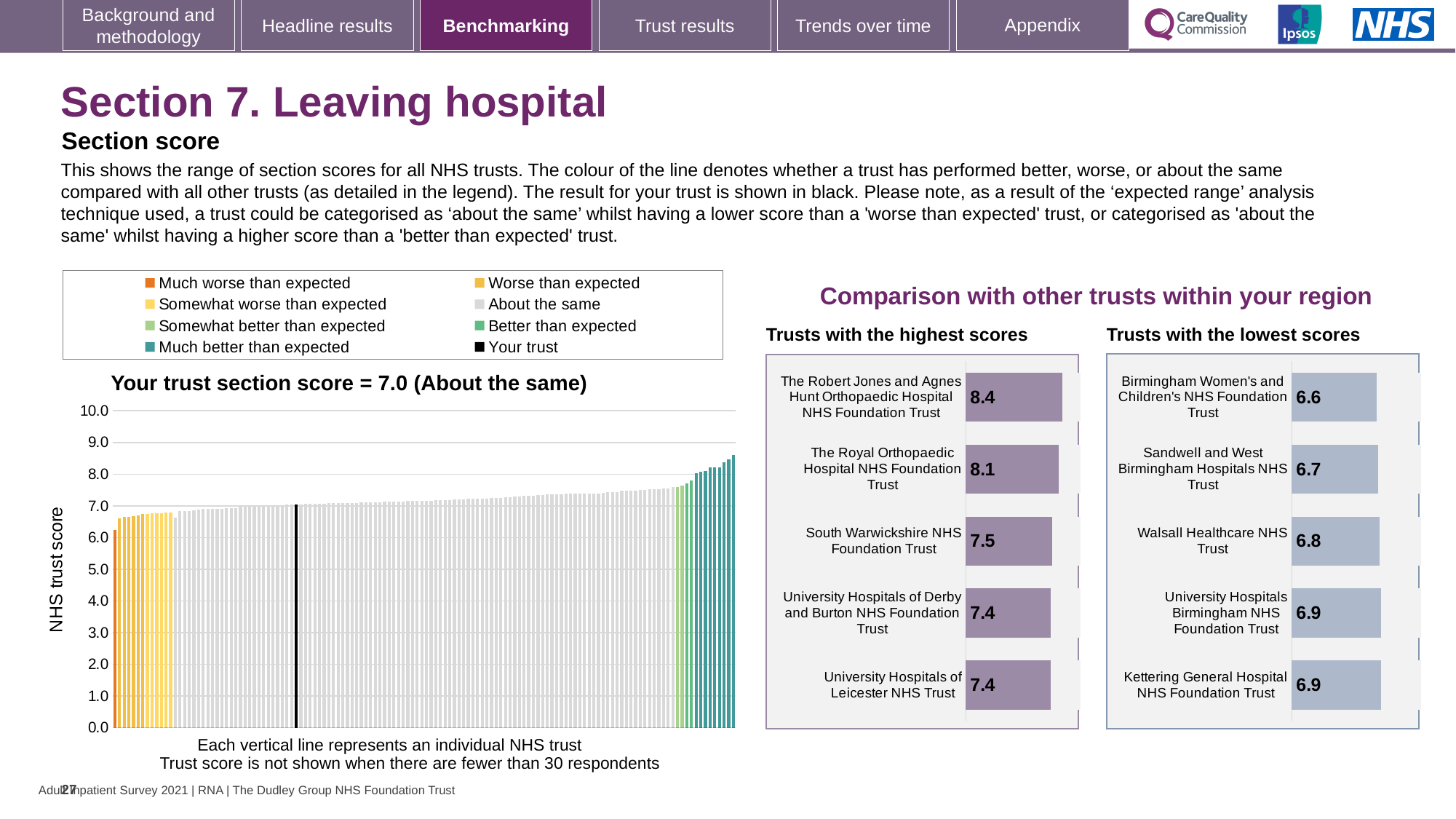
On the 'Trusts with the highest scores' chart, what is the score for The Royal Orthopaedic Hospital NHS Foundation Trust? 8.1 What is the y-axis label on the 'Your trust section score' chart? NHS trust score On the 'Trusts with the highest scores' chart, which trust has the highest score? The Robert Jones and Agnes Hunt Orthopaedic Hospital NHS Foundation Trust On the 'Trusts with the lowest scores' chart, how many trusts are shown? 5 On the 'Trusts with the lowest scores' chart, which trust has the lowest score? Birmingham Women's and Children's NHS Foundation Trust What kind of chart is the 'Your trust section score' chart? bar chart On the 'Trusts with the highest scores' chart, what is the difference between the scores of The Robert Jones and Agnes Hunt Orthopaedic Hospital NHS Foundation Trust and The Royal Orthopaedic Hospital NHS Foundation Trust? 0.3 On the 'Your trust section score' chart, do the values rise or fall from left to right along the x axis? rise On the 'Your trust section score' chart, is the value of the rightmost bar greater or less than 8.0? greater On the 'Your trust section score' chart, what is the section score for your trust? 7.0 On the 'Your trust section score' chart, is the value of the leftmost bar greater or less than 7.0? less How many entries does the legend above the 'Your trust section score' chart list? 8